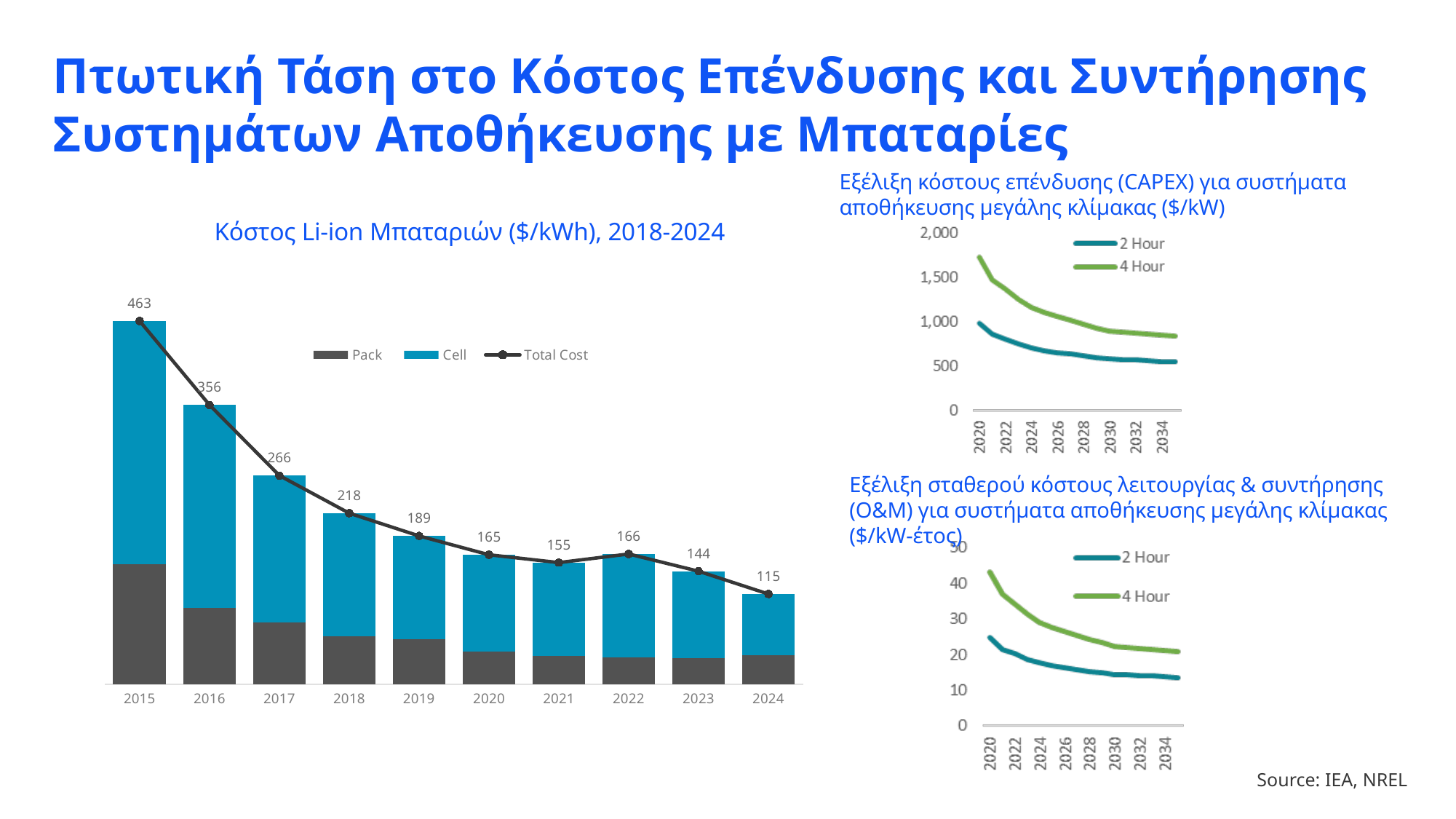
In the left chart (Κόστος Li-ion Μπαταριών), what is the Total Cost for 2015? 463 In the left chart (Κόστος Li-ion Μπαταριών), what is the difference in Total Cost between 2015 and 2016? 107 In the left chart (Κόστος Li-ion Μπαταριών), what is the Total Cost for 2020? 165 In the top-right CAPEX chart, is the 2 Hour value for 2034 greater or less than 1,000? less In the left chart (Κόστος Li-ion Μπαταριών), which year has the larger Total Cost, 2021 or 2022? 2022 In the left chart (Κόστος Li-ion Μπαταριών), what is the Total Cost for 2024? 115 In the bottom-right O&M chart, do the 4 Hour values rise or fall from 2020 to 2034? fall In the left chart (Κόστος Li-ion Μπαταριών), how many years are shown on the x axis? 10 In the left chart (Κόστος Li-ion Μπαταριών), which year has the highest Total Cost? 2015 In the top-right CAPEX chart, is the 4 Hour value for 2020 greater or less than 1,500? greater In the left chart (Κόστος Li-ion Μπαταριών), how many series does the legend list? 3 In the left chart (Κόστος Li-ion Μπαταριών), which year has the lowest Total Cost? 2024